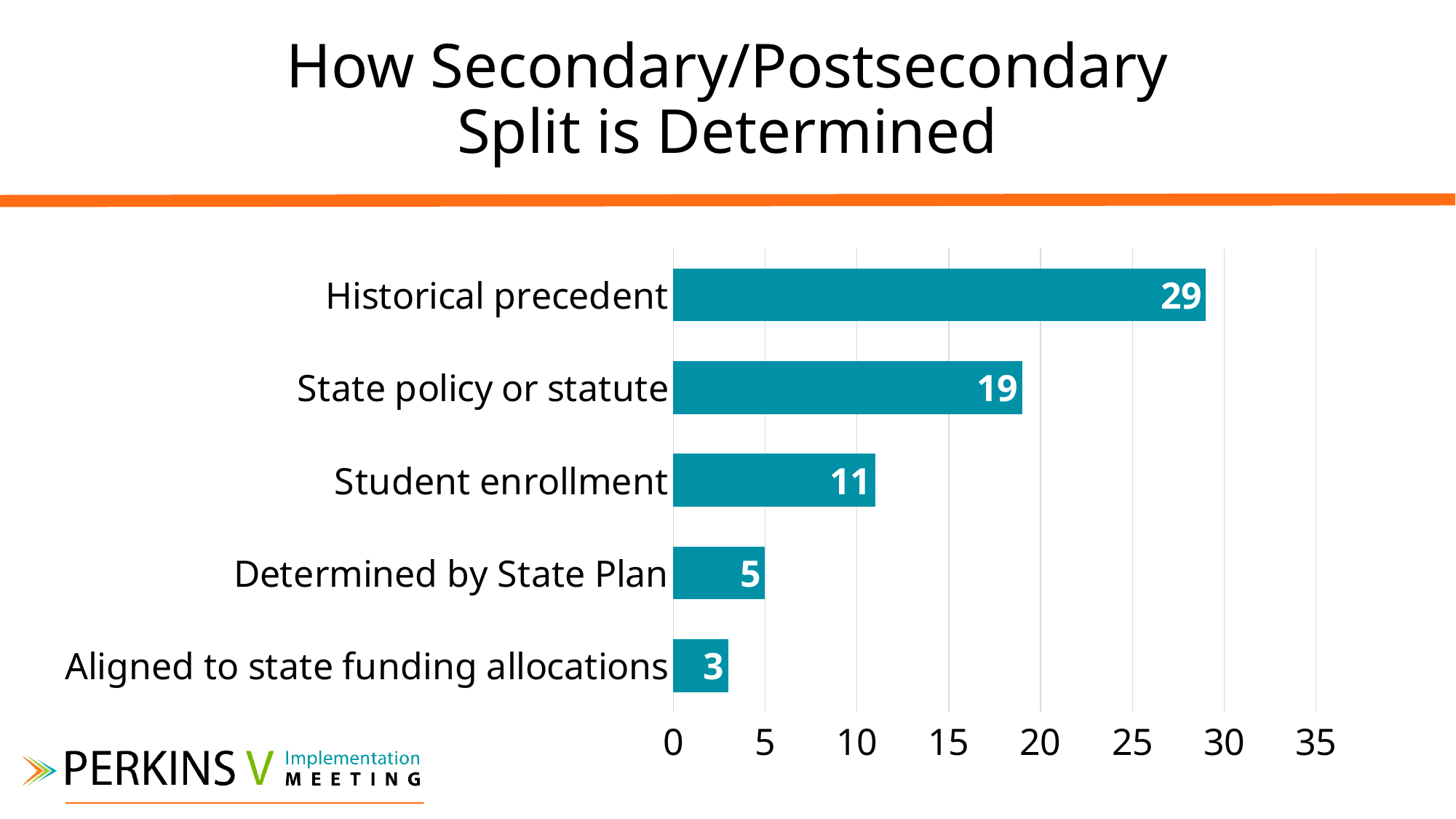
What is the difference between the values for Student enrollment and Determined by State Plan? 6 Which is larger, the value for State policy or statute or the value for Student enrollment? State policy or statute What is the title of the slide? How Secondary/Postsecondary Split is Determined What is the value for State policy or statute? 19 What is the value for Historical precedent? 29 Which category has the lowest value? Aligned to state funding allocations Which category has the highest value? Historical precedent What is the value for Student enrollment? 11 How many categories are shown in the chart? 5 What is the difference between the values for Historical precedent and State policy or statute? 10 What is the value for Aligned to state funding allocations? 3 What kind of chart is shown on the slide? Bar chart